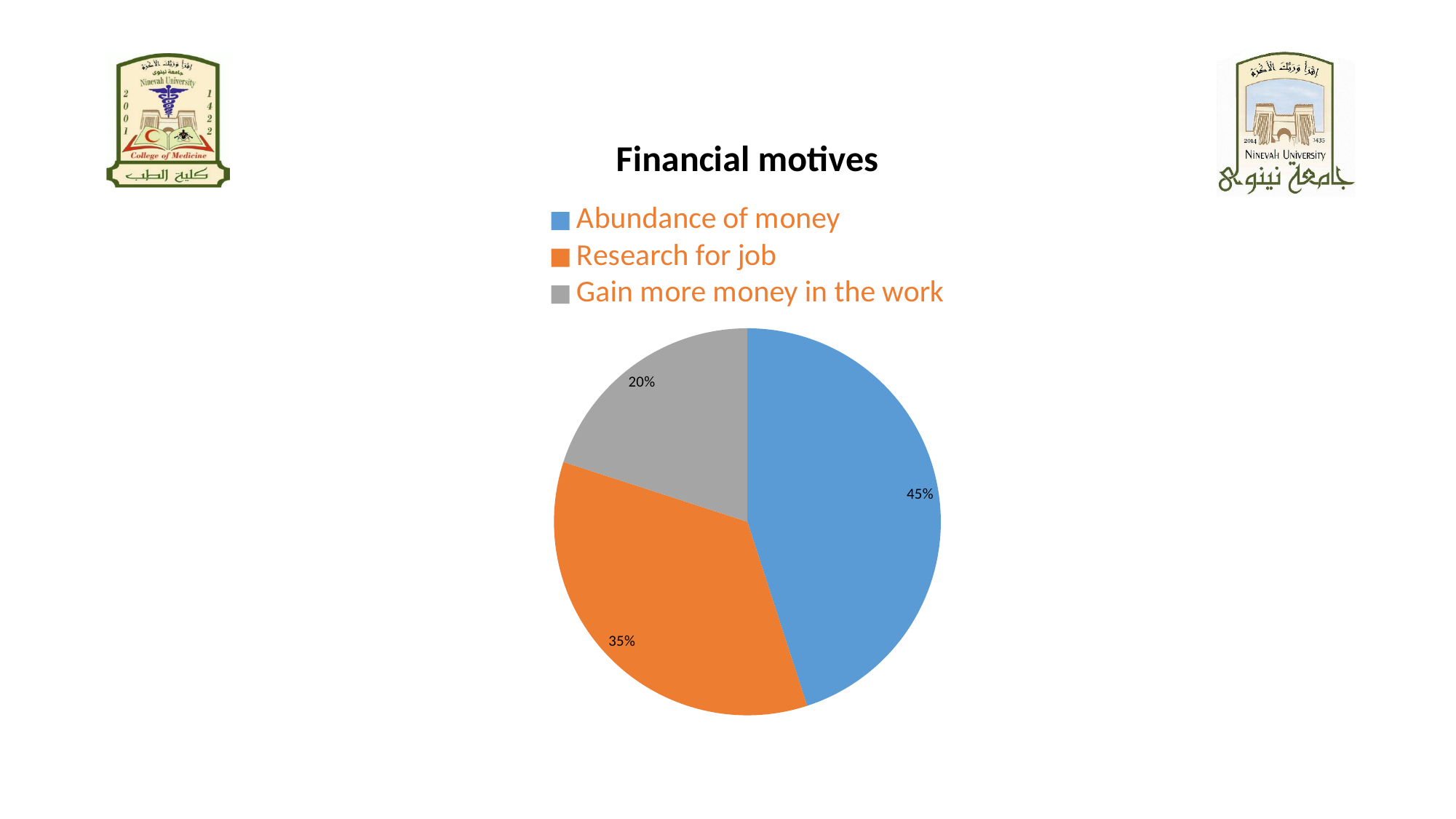
What is the title of the chart? Financial motives Which category has the smallest slice of the pie? Gain more money in the work How many categories are shown in the pie chart? 3 Which colour represents Research for job in the pie chart? Orange Which category has the largest slice of the pie? Abundance of money Which is larger, the slice for Research for job or the slice for Gain more money in the work? Research for job What share of the pie does Gain more money in the work represent? 20% What share of the pie does Research for job represent? 35% What kind of chart is shown on the slide? Pie chart What share of the pie does Abundance of money represent? 45% What is the difference in percentage points between Research for job and Gain more money in the work? 15 What is the difference in percentage points between Abundance of money and Research for job? 10